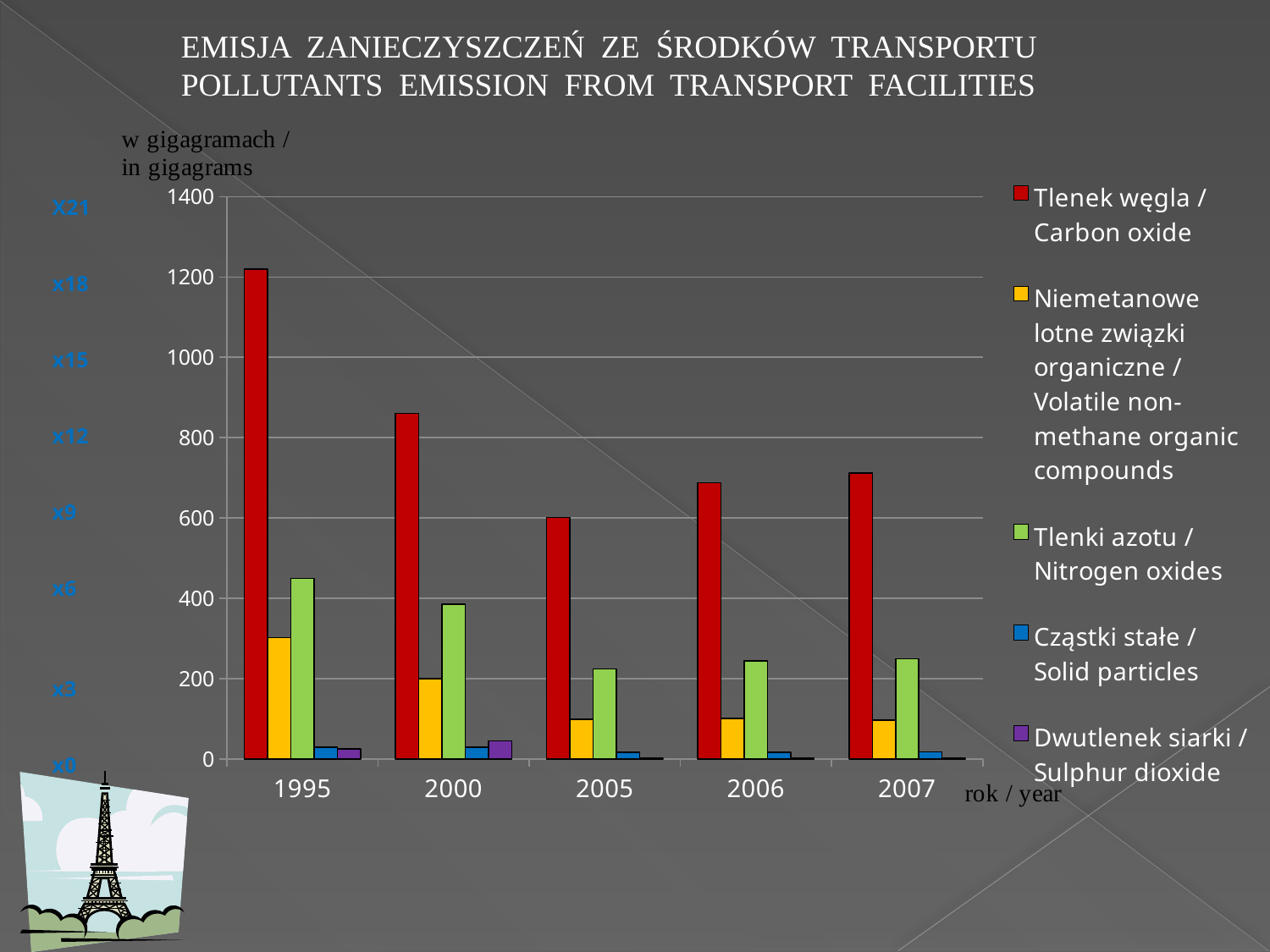
In what unit are the emissions measured according to the axis label? gigagrams Is the Carbon oxide value for 2000 greater or less than 800? greater Is the Carbon oxide value for 1995 greater or less than 1000? greater In which year is the Carbon oxide emission lowest? 2005 In which year is the Carbon oxide emission highest? 1995 Which is larger in 1995: Nitrogen oxides or Volatile non-methane organic compounds? Nitrogen oxides Does the Carbon oxide emission rise or fall from 1995 to 2005? fall Is the Volatile non-methane organic compounds value for 2005 greater or less than 200? less How many years are shown on the x axis? 5 How many series does the legend list? 5 What kind of chart is shown on the slide? bar chart